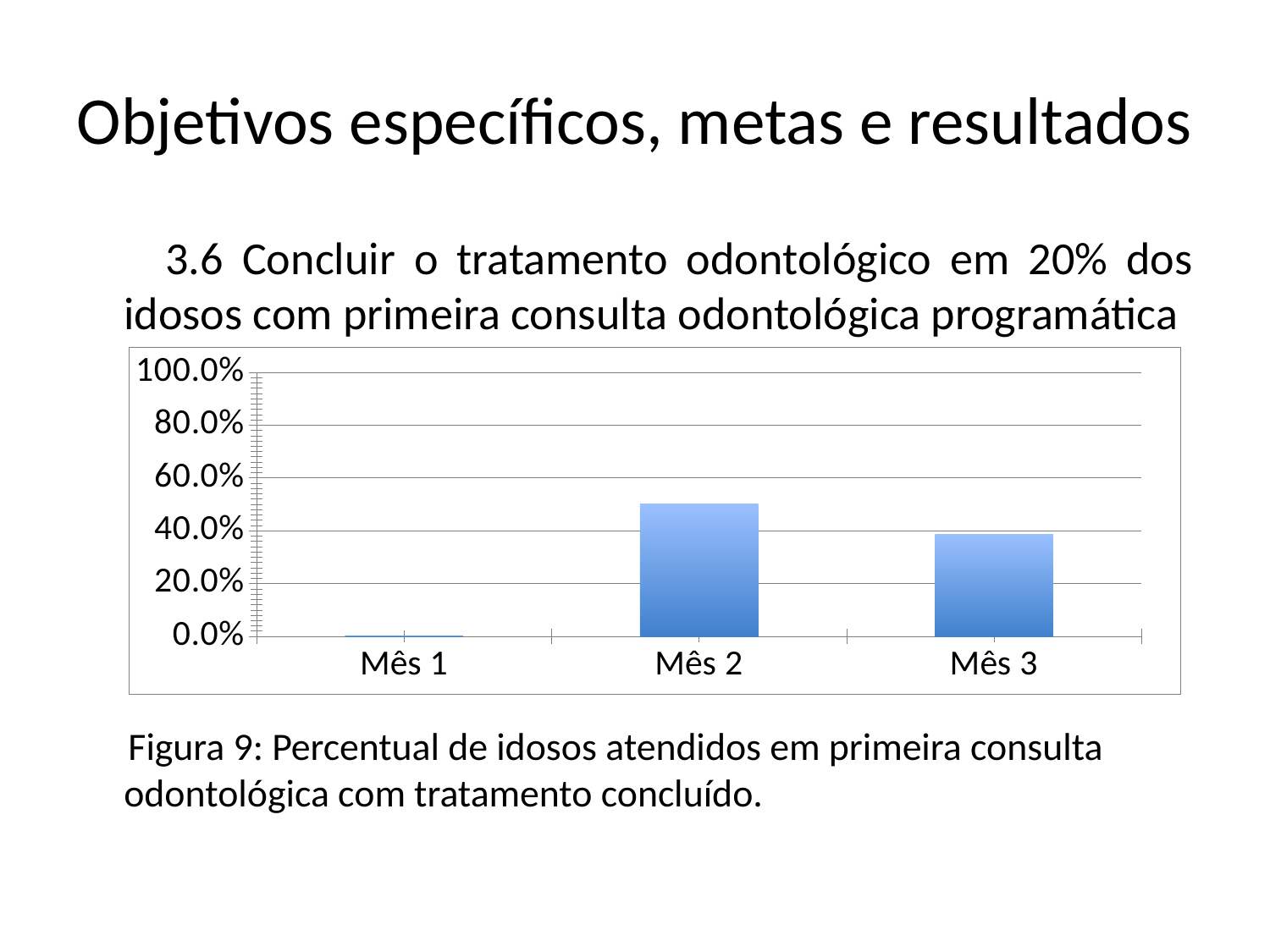
Is the value for Mês 2 greater or less than 60.0%? less Is the value for Mês 1 greater or less than 20.0%? less What figure number is given in the caption below the chart? Figura 9 How many categories are shown on the x axis of the chart? 3 Which is larger, the value for Mês 2 or the value for Mês 3? Mês 2 What kind of chart is shown on the slide? bar chart Is the value for Mês 3 greater or less than 20.0%? greater Which month has the highest value in the chart? Mês 2 What is the highest value shown on the vertical axis of the chart? 100.0% Does the value fall or rise from Mês 2 to Mês 3? fall Which month has the lowest value in the chart? Mês 1